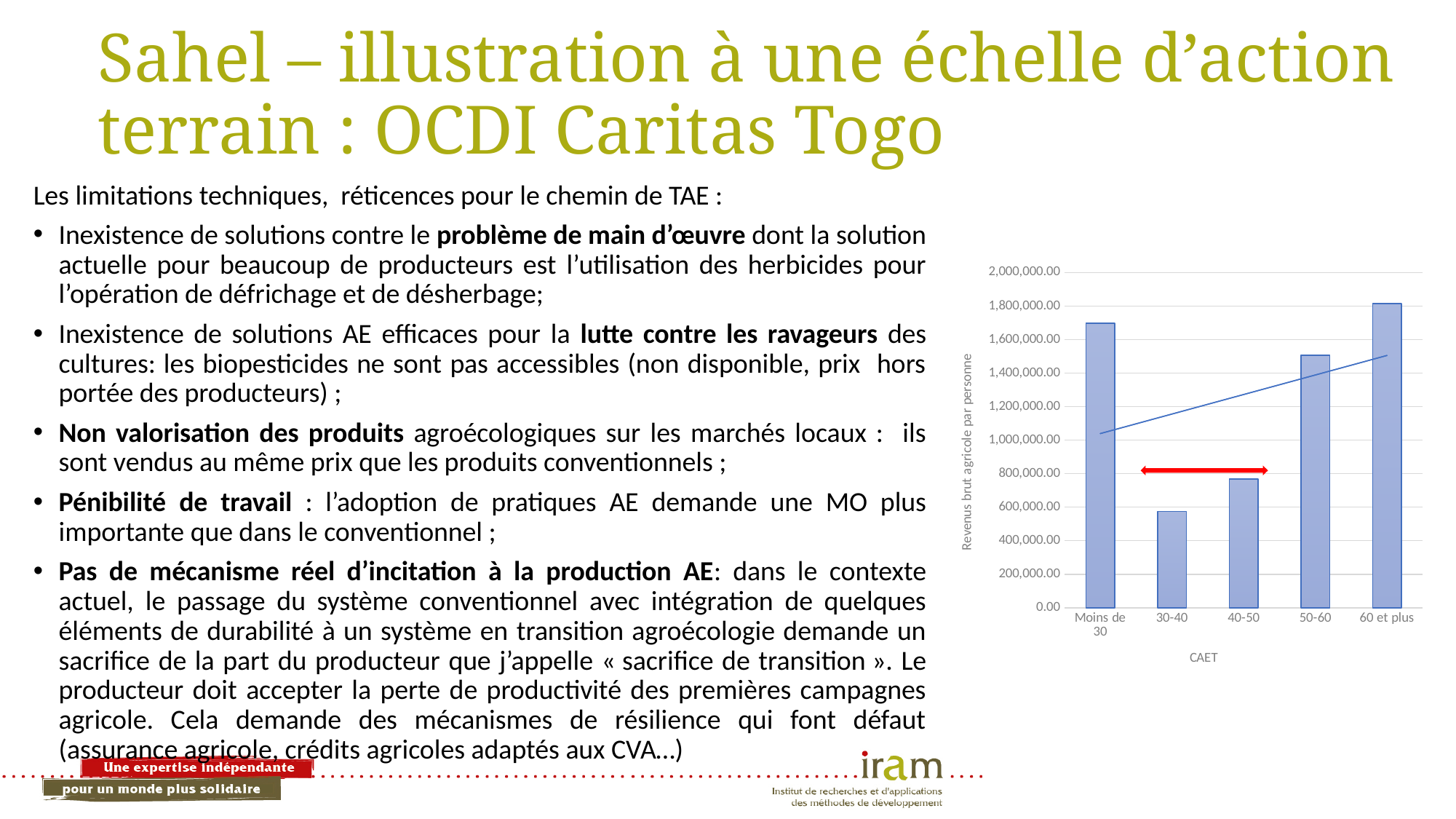
Which has the larger value, '50-60' or '40-50'? 50-60 What is the title of the vertical axis of the chart? Revenus brut agricole par personne Which CAET category has the highest value in the chart? 60 et plus Which has the larger value, 'Moins de 30' or '30-40'? Moins de 30 How many CAET categories are plotted on the x axis of the chart? 5 Is the value for '30-40' greater or less than 800,000.00? less Is the value for '40-50' greater or less than 1,000,000.00? less What kind of chart is shown on the slide? bar chart Is the value for 'Moins de 30' greater or less than 1,600,000.00? greater What is the title of the horizontal axis of the chart? CAET Which CAET category has the lowest value in the chart? 30-40